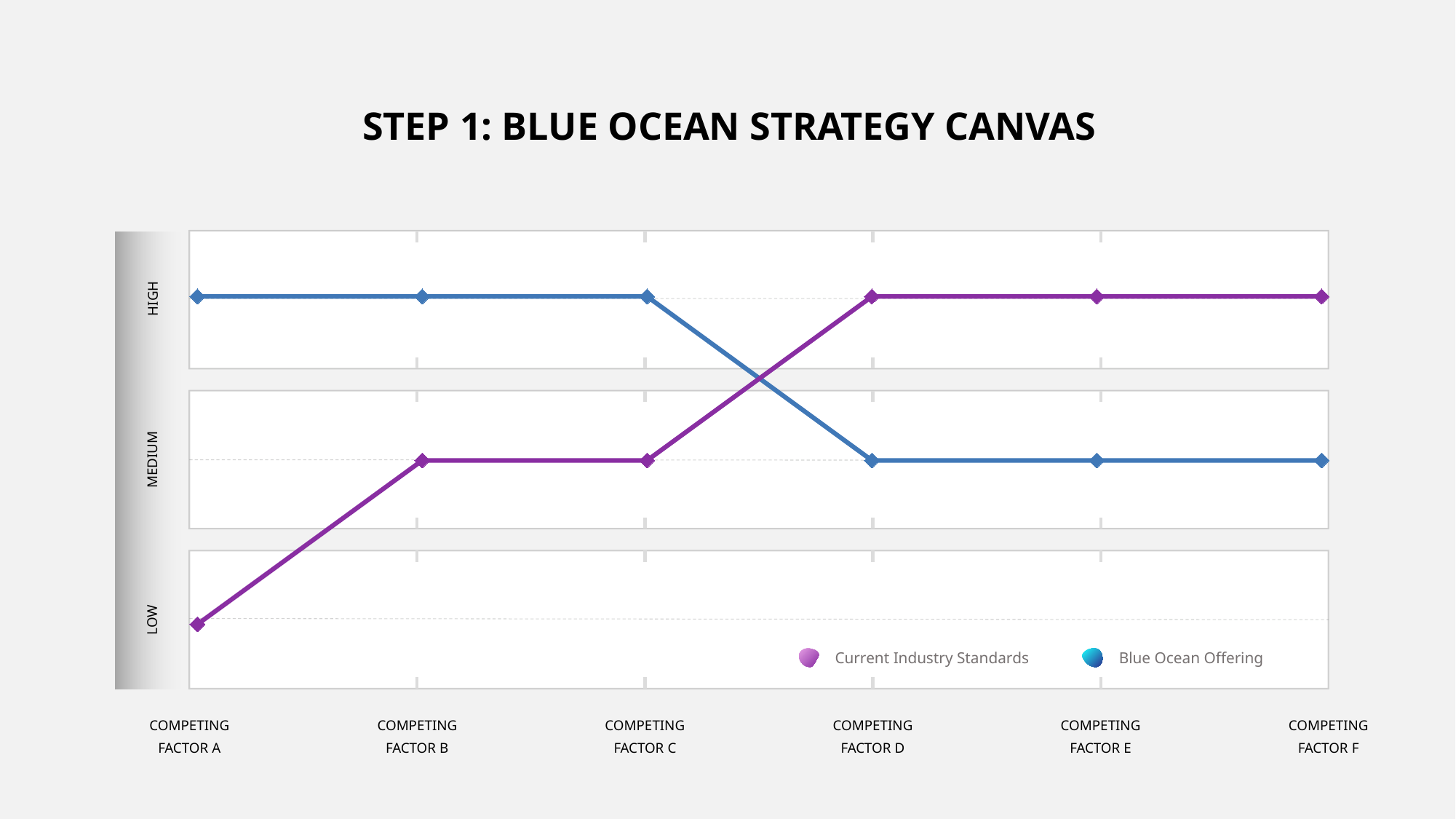
For Competing Factor B, which series is higher: Current Industry Standards or Blue Ocean Offering? Blue Ocean Offering What kind of chart is shown on the slide? Line chart For Competing Factor D, which series is higher: Current Industry Standards or Blue Ocean Offering? Current Industry Standards How many series does the legend list? 2 At what level is Current Industry Standards for Competing Factor A? LOW At what level is Current Industry Standards for Competing Factor C? MEDIUM At what level is Blue Ocean Offering for Competing Factor E? MEDIUM At what level is Current Industry Standards for Competing Factor F? HIGH What is the title of the slide? STEP 1: BLUE OCEAN STRATEGY CANVAS At what level is Blue Ocean Offering for Competing Factor A? HIGH Does the Blue Ocean Offering line rise or fall from Competing Factor C to Competing Factor D? Fall How many competing factors are plotted along the x axis? 6